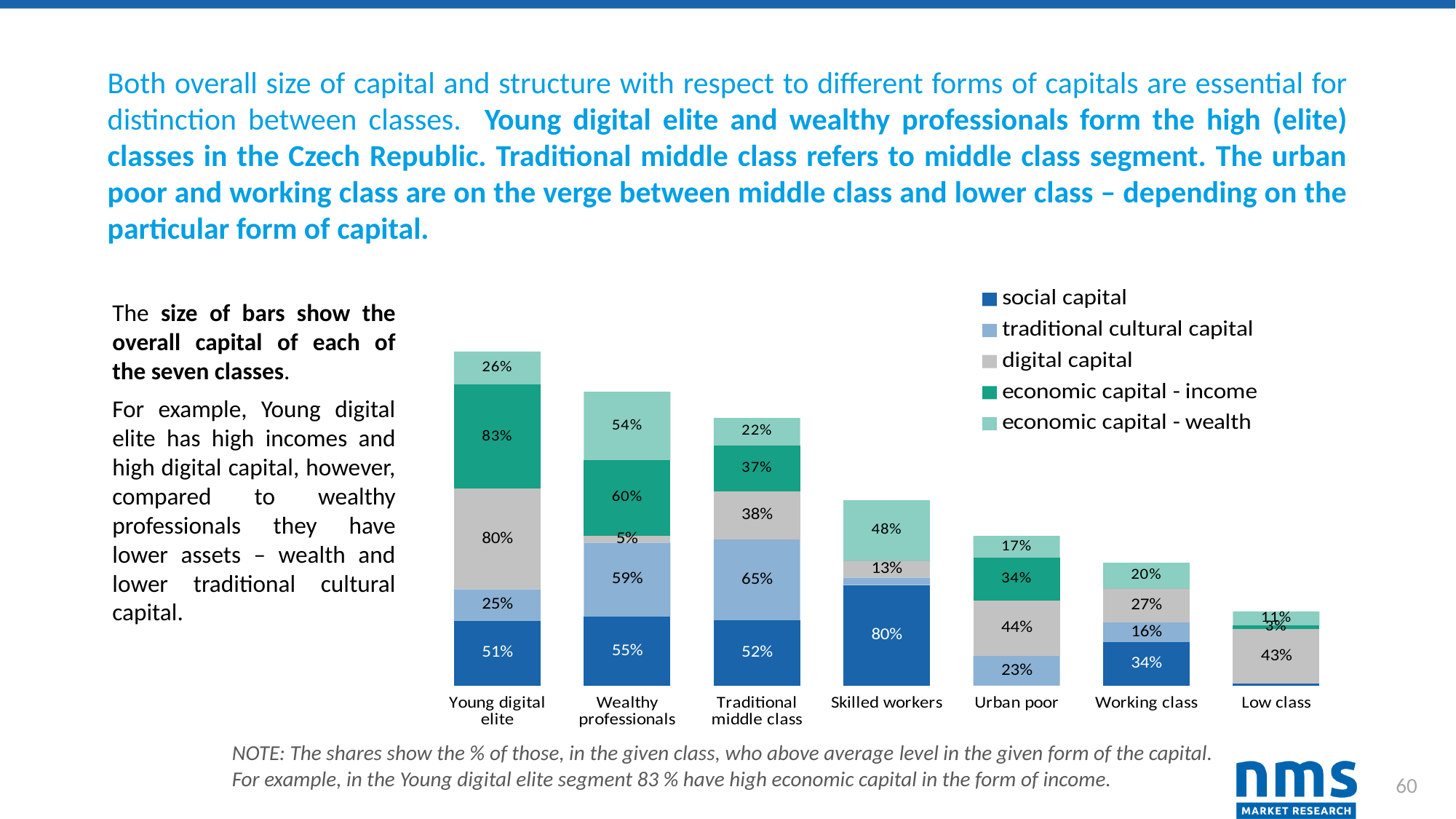
What is the total of all segments in the Young digital elite bar? 265% What kind of chart is shown on the slide? Stacked bar chart Which class has the lowest economic capital - wealth value? Low class How many series does the legend list? 5 What is the digital capital value for Urban poor? 44% Which class has the highest social capital value? Skilled workers Which has the larger traditional cultural capital value, Wealthy professionals or Traditional middle class? Traditional middle class What is the economic capital - wealth value for Working class? 20% How many classes (categories) are shown on the x axis? 7 What is the economic capital - income value for Young digital elite? 83% What is the social capital value for Skilled workers? 80% What is the difference in digital capital between Young digital elite and Wealthy professionals? 75 percentage points